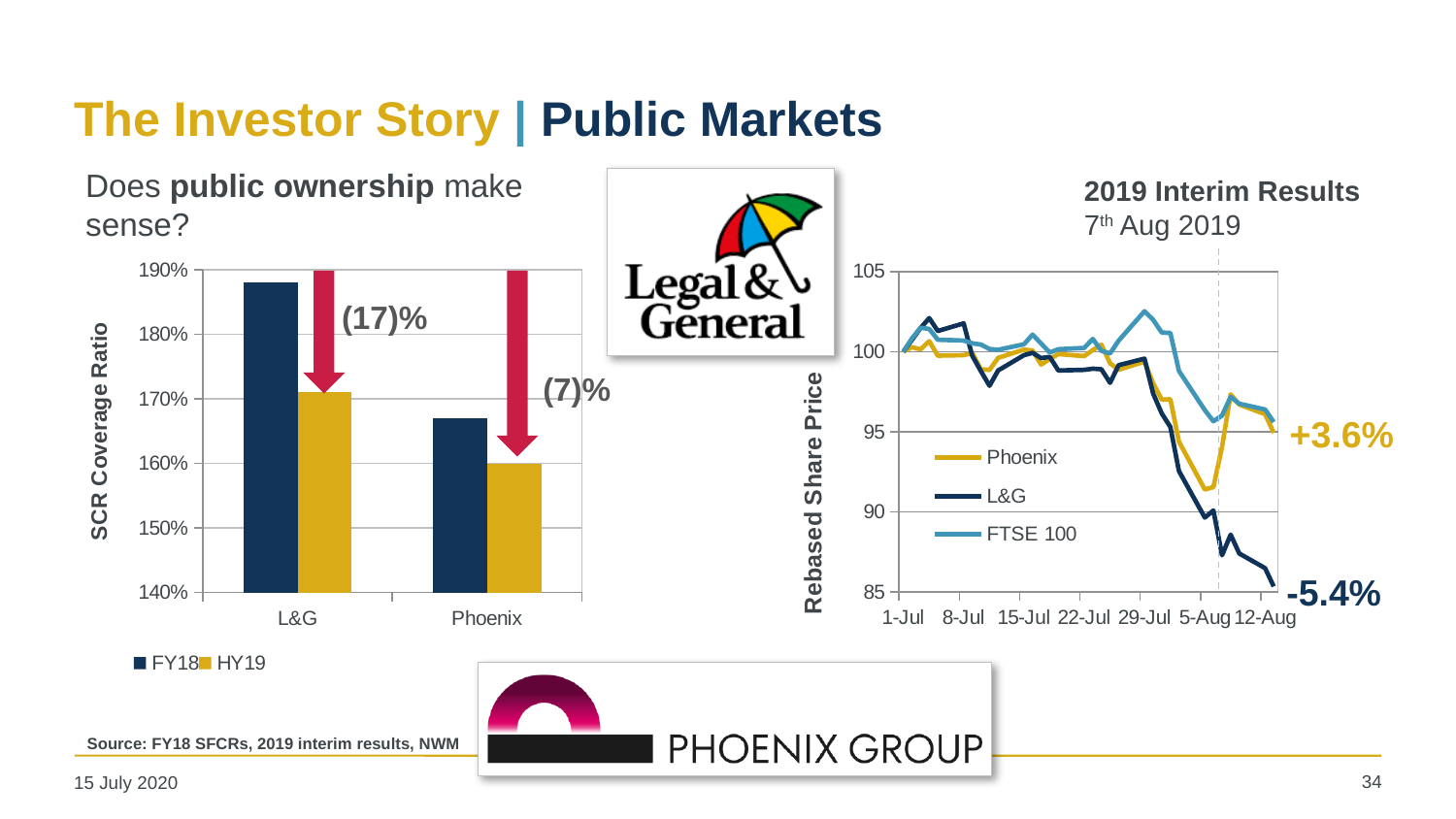
In the SCR Coverage Ratio chart, what percentage change is annotated above the Phoenix bars? (7)% How many series does the legend of the SCR Coverage Ratio chart list? 2 In the Rebased Share Price chart, which series is lowest at 12-Aug? L&G In the SCR Coverage Ratio chart, is the FY18 value for Phoenix greater or less than 170%? less What kind of chart is the Rebased Share Price chart on the right? line chart What kind of chart is the SCR Coverage Ratio chart on the left? bar chart How many series does the legend of the Rebased Share Price chart list? 3 How many companies are shown on the x axis of the SCR Coverage Ratio chart? 2 In the SCR Coverage Ratio chart, is the FY18 value for L&G greater or less than 180%? greater In the SCR Coverage Ratio chart, what percentage change is annotated above the L&G bars? (17)% In the SCR Coverage Ratio chart, which company has the higher FY18 coverage ratio, L&G or Phoenix? L&G In the Rebased Share Price chart, does the L&G line rise or fall overall from 1-Jul to 12-Aug? fall